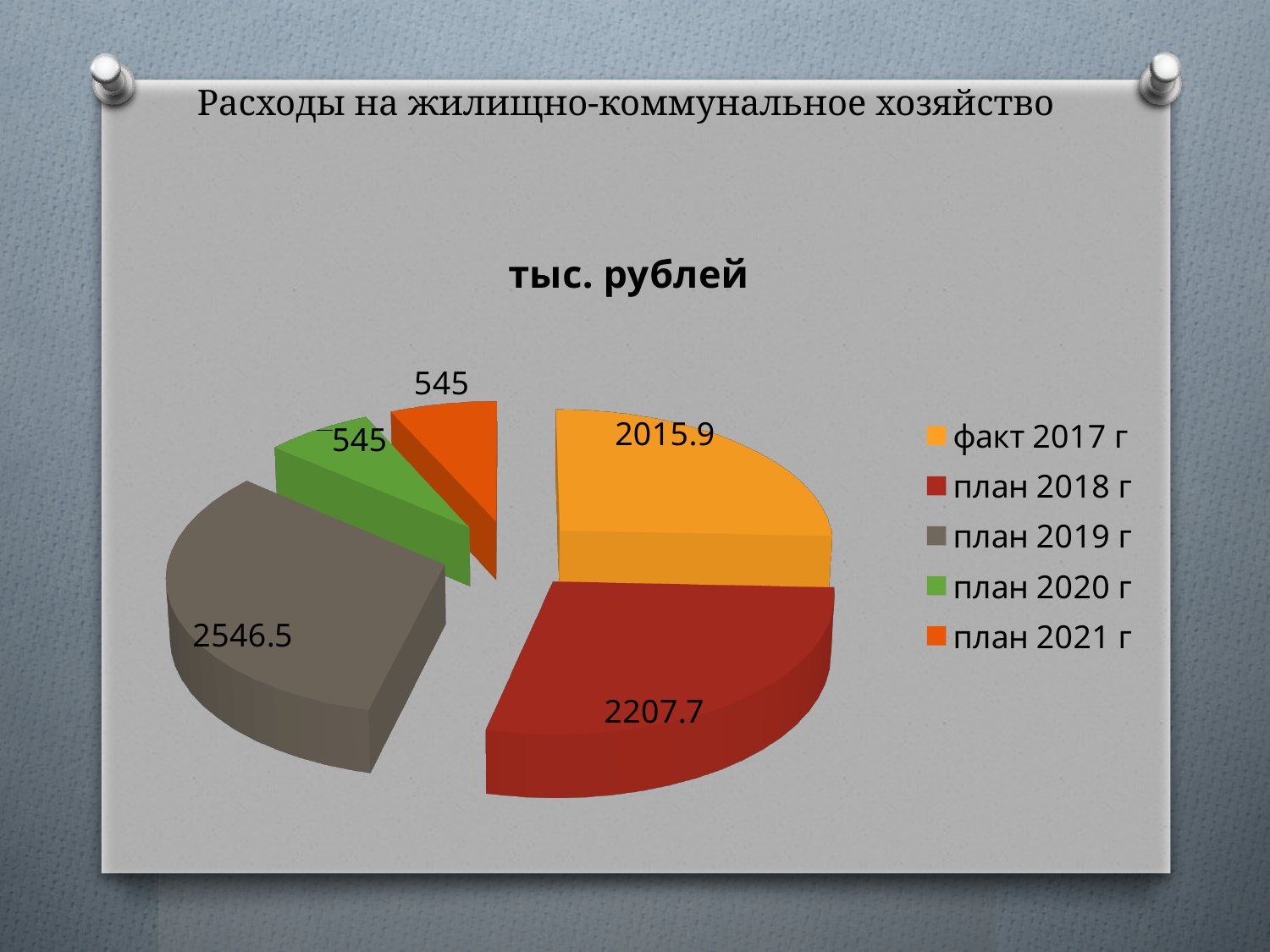
What is the value for факт 2017 г? 2015.9 What is the value for план 2018 г? 2207.7 What is the difference between the values for план 2019 г and план 2018 г? 338.8 Which two categories share the smallest value in the pie? план 2020 г and план 2021 г Which is larger, the value for план 2018 г or the value for факт 2017 г? план 2018 г Which category has the largest slice of the pie? план 2019 г What kind of chart is shown on the slide? pie chart How many slices does the pie chart have? 5 What is the title of the chart? тыс. рублей What is the value for план 2021 г? 545 What is the value for план 2019 г? 2546.5 What is the difference between the values for план 2018 г and факт 2017 г? 191.8